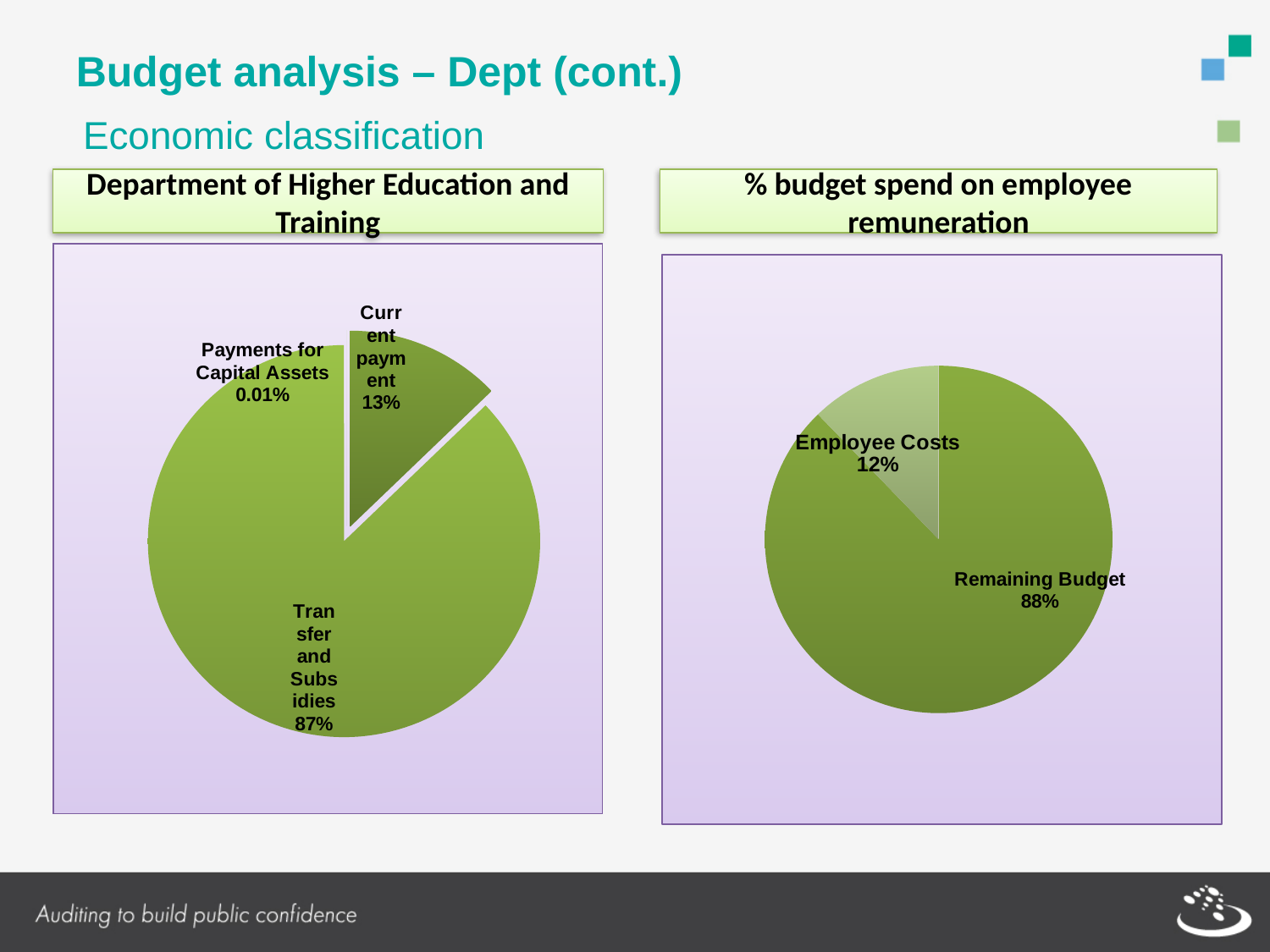
In the % budget spend on employee remuneration chart, which is larger, Employee Costs or Remaining Budget? Remaining Budget In the % budget spend on employee remuneration chart, what share is Remaining Budget? 88% What type of chart is the % budget spend on employee remuneration chart? Pie chart In the Department of Higher Education and Training pie chart, what share does Current payment have? 13% In the Department of Higher Education and Training pie chart, what share does Transfer and Subsidies have? 87% In the Department of Higher Education and Training pie chart, what share does Payments for Capital Assets have? 0.01% In the Department of Higher Education and Training pie chart, how many slices are there? 3 In the Department of Higher Education and Training pie chart, what is the difference between the Transfer and Subsidies share and the Current payment share? 74 percentage points In the Department of Higher Education and Training pie chart, which category has the largest share? Transfer and Subsidies How many charts are shown on the slide? 2 In the Department of Higher Education and Training pie chart, which category has the smallest share? Payments for Capital Assets In the % budget spend on employee remuneration chart, what share is Employee Costs? 12%